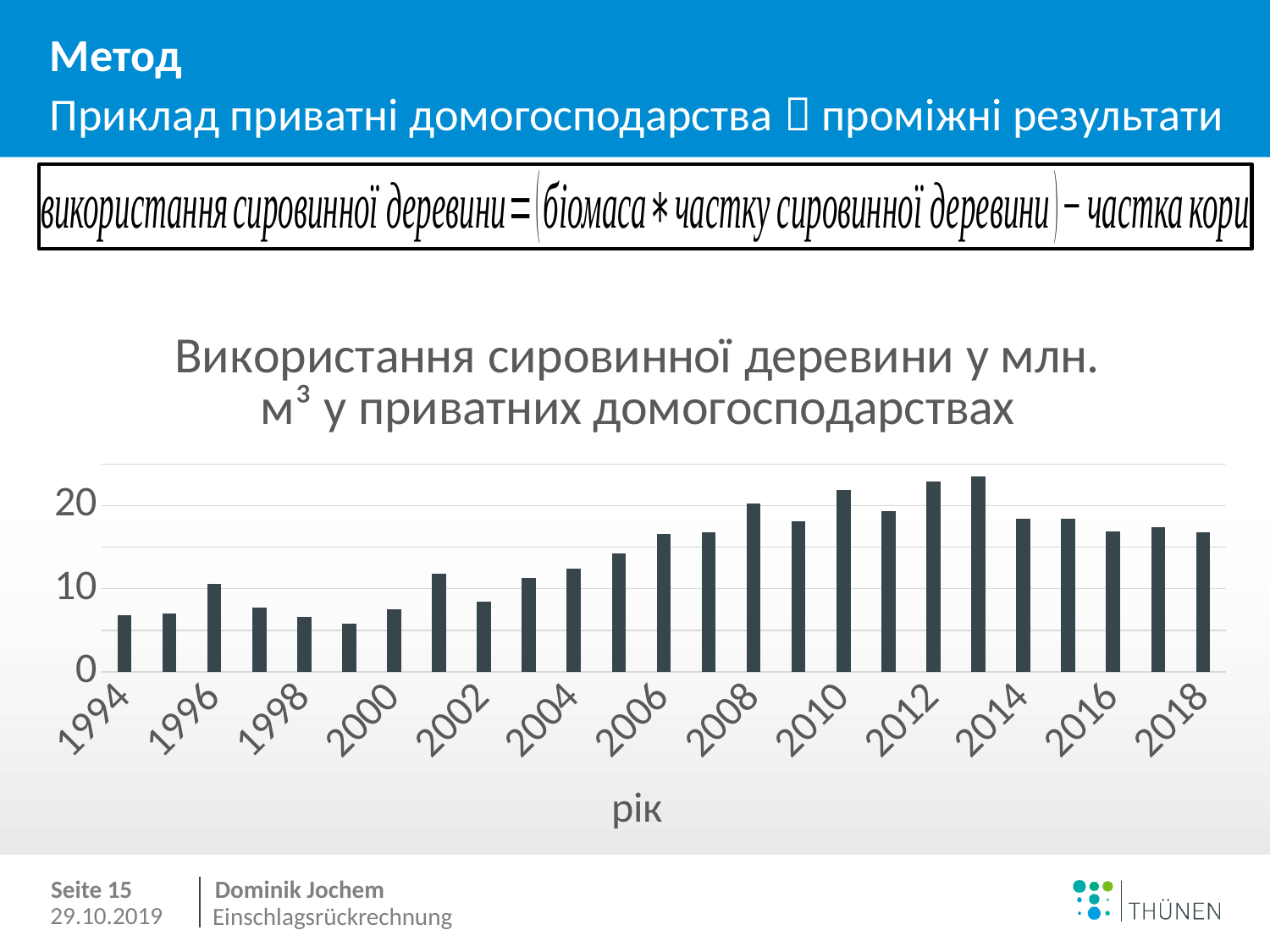
How many years (bars) are plotted in the chart? 25 Is the value for 2010 greater or less than 20? greater Do the values generally rise or fall from 1999 to 2013? rise Which year has the larger value, 1996 or 1999? 1996 What kind of chart is shown on the slide? bar chart What is the title of the chart? Використання сировинної деревини у млн. м³ у приватних домогосподарствах Which year has the larger value, 2000 or 2010? 2010 Is the value for 1994 greater or less than 10? less What is the label of the x axis? рік Is the value for 2001 greater or less than 10? greater Which year has the lowest value in the chart? 1999